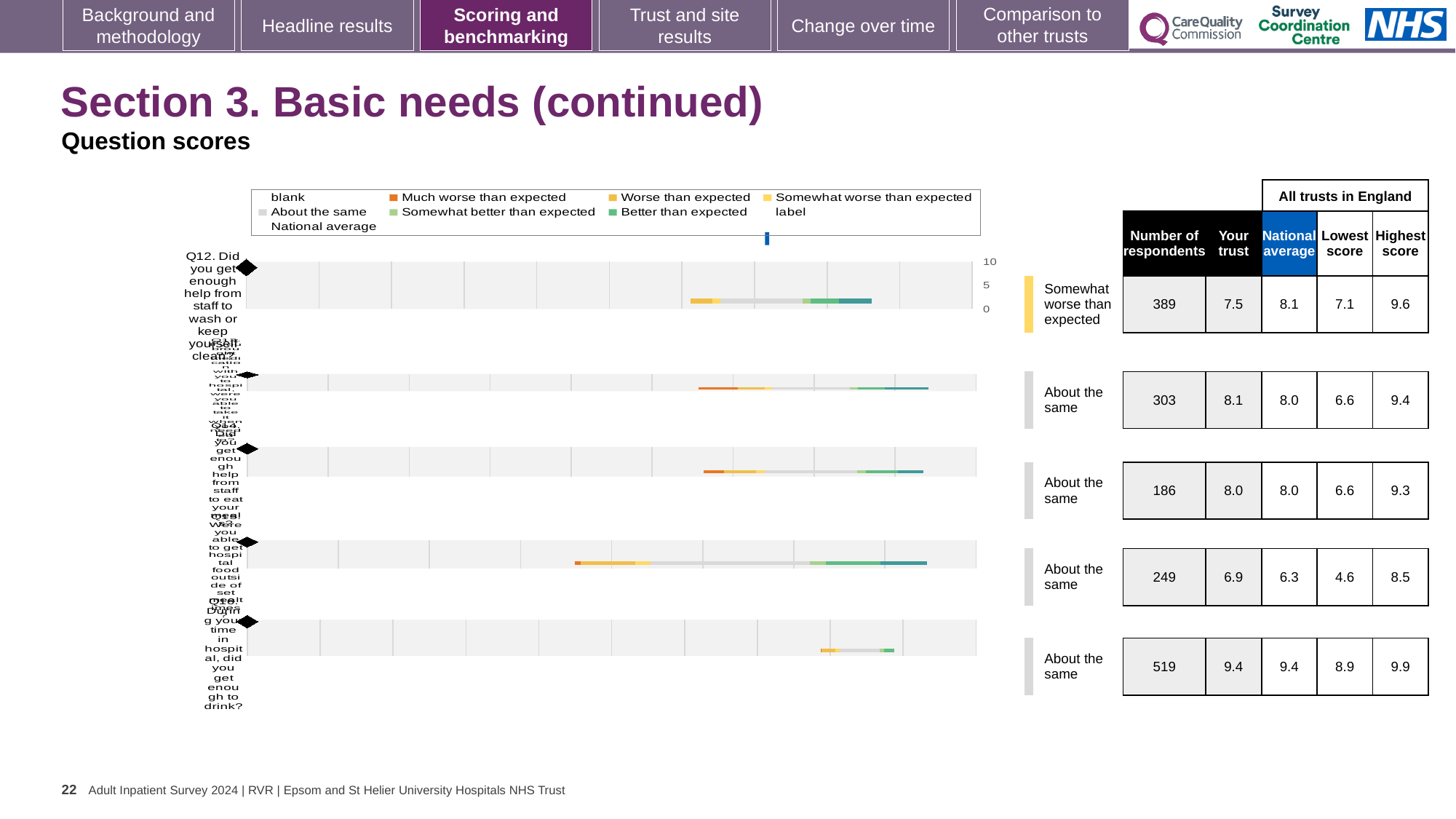
For Q12, which is larger: the 'Your trust' score or the national average? National average What is the 'Your trust' score for Q12 (help from staff to wash or keep yourself clean)? 7.5 Which row has the highest 'Your trust' score, and what is it? The fifth (last) row, 9.4 Which row has the lowest 'Your trust' score, and what is it? The fourth row, 6.9 What is the number of respondents for Q12 (help from staff to wash or keep yourself clean)? 389 In the chart legend, which entry is shown in dark green? Better than expected In the chart legend, which colour represents 'Much worse than expected'? orange For Q12, what is the difference between the highest score (9.6) and the lowest score (7.1) across all trusts in England? 2.5 How many question rows (bars) are shown in the chart? 5 How many of the five question rows are rated 'About the same'? 4 What kind of chart is used to show the question scores on this slide? bar chart What is the national average score for Q12 (help from staff to wash or keep yourself clean)? 8.1